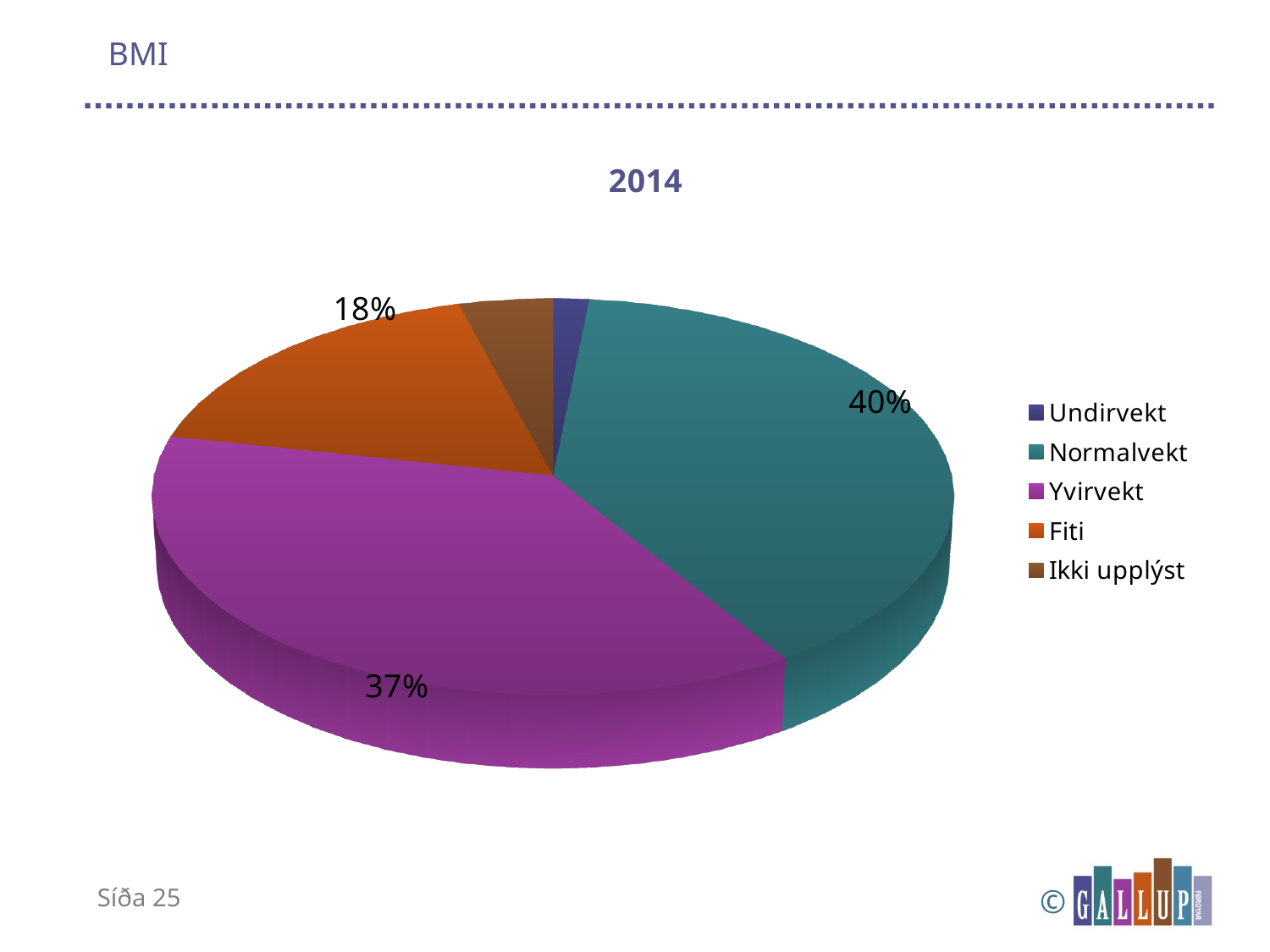
What share of the pie does Normalvekt have? 40% How many categories does the pie chart show? 5 Which category has the smallest slice of the pie? Undirvekt What is the difference in percentage points between Normalvekt and Yvirvekt? 3 percentage points What share of the pie does Fiti have? 18% Which is larger, the Yvirvekt slice or the Fiti slice? Yvirvekt Which category is shown in orange in the legend? Fiti Which category has the largest slice of the pie? Normalvekt What share of the pie does Yvirvekt have? 37% What is the difference in percentage points between Normalvekt and Fiti? 22 percentage points What kind of chart is shown on the slide? Pie chart What is the title of the chart? 2014